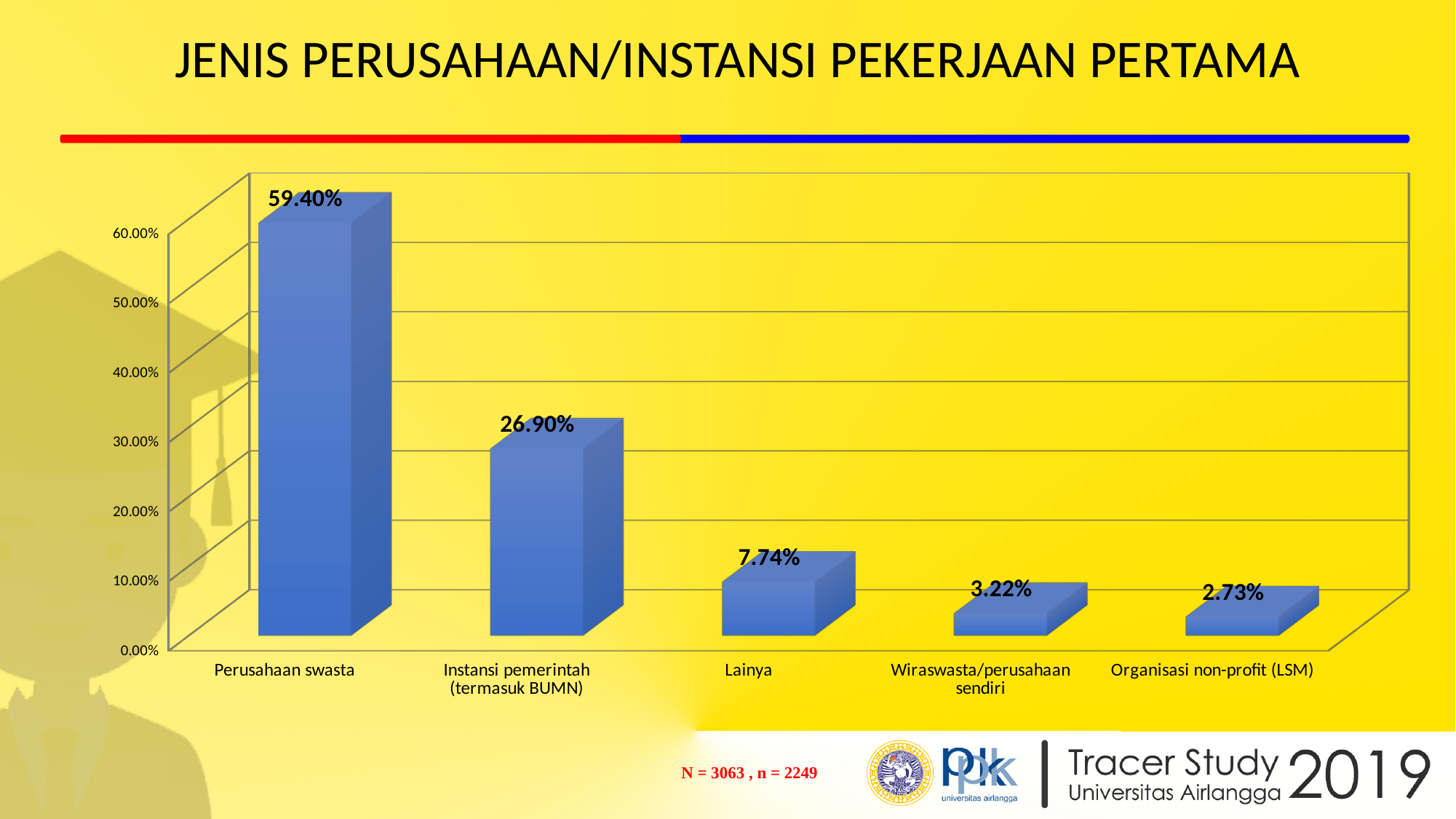
What is the title of the chart on the slide? JENIS PERUSAHAAN/INSTANSI PEKERJAAN PERTAMA Which category has the highest value? Perusahaan swasta What is the value for Wiraswasta/perusahaan sendiri? 3.22% How many categories are shown in the chart? 5 What kind of chart is shown on the slide? Bar chart Which category has the lowest value? Organisasi non-profit (LSM) What is the value for Instansi pemerintah (termasuk BUMN)? 26.90% What is the value for Perusahaan swasta? 59.40% What is the value for Organisasi non-profit (LSM)? 2.73% What is the value for Lainya? 7.74% What is the difference between the values for Perusahaan swasta and Instansi pemerintah (termasuk BUMN)? 32.50% Which is larger, the value for Lainya or the value for Wiraswasta/perusahaan sendiri? Lainya